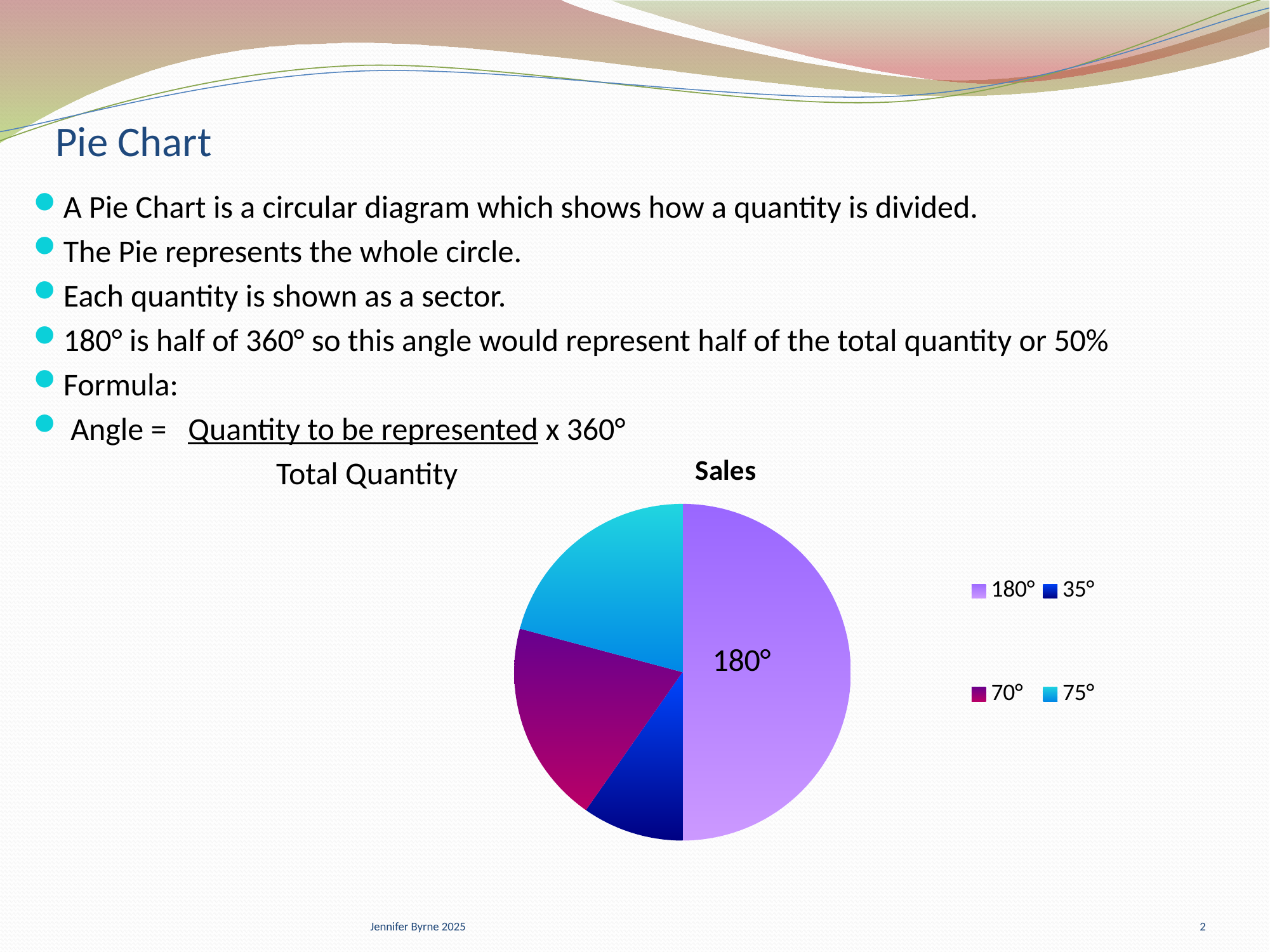
What data label is printed on the largest slice of the Sales pie chart? 180° Which legend entry corresponds to the smallest slice of the Sales pie chart? 35° What colour is the 180° slice in the Sales pie chart? purple Which slice is larger in the Sales pie chart, the 70° slice or the 35° slice? 70° How many entries does the legend of the Sales pie chart list? 4 What share of the Sales pie chart does the 180° slice represent? 50% What is the title of the pie chart? Sales Which legend entry corresponds to the largest slice of the Sales pie chart? 180° How many slices does the Sales pie chart have? 4 Which slice is larger in the Sales pie chart, the 180° slice or the 75° slice? 180° What kind of chart is shown on the slide? pie chart